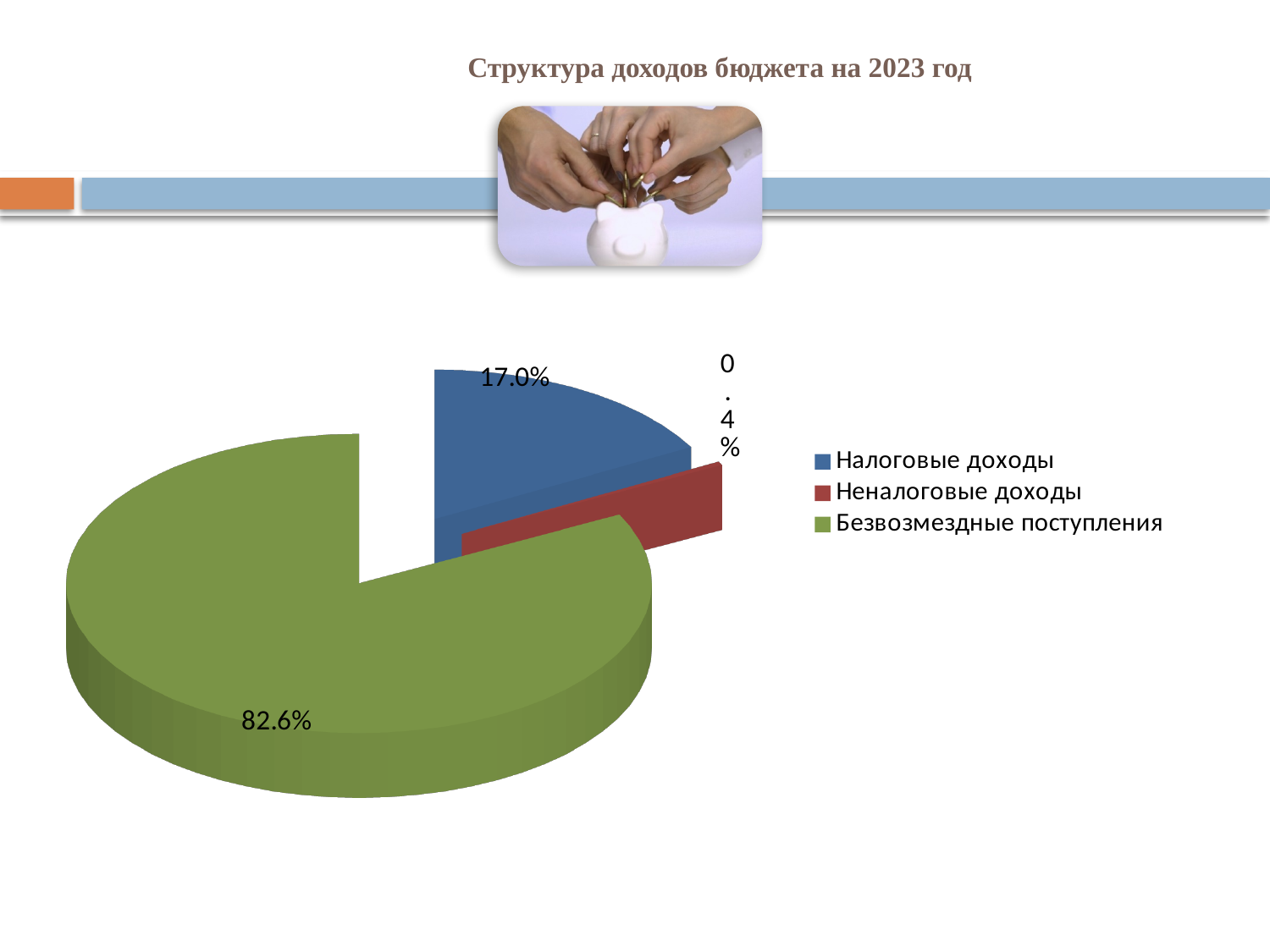
Which category has the smallest share of the pie? Неналоговые доходы Which colour represents Безвозмездные поступления in the legend? green What share of the pie does Налоговые доходы have? 17.0% What kind of chart is shown on the slide? pie chart What is the difference between the shares of Налоговые доходы and Неналоговые доходы? 16.6% What share of the pie does Неналоговые доходы have? 0.4% What is the difference between the shares of Безвозмездные поступления and Налоговые доходы? 65.6% Which category has the largest share of the pie? Безвозмездные поступления How many slices does the pie chart have? 3 What is the title of the slide above the chart? Структура доходов бюджета на 2023 год What share of the pie does Безвозмездные поступления have? 82.6% Which is larger, the share of Налоговые доходы or the share of Неналоговые доходы? Налоговые доходы